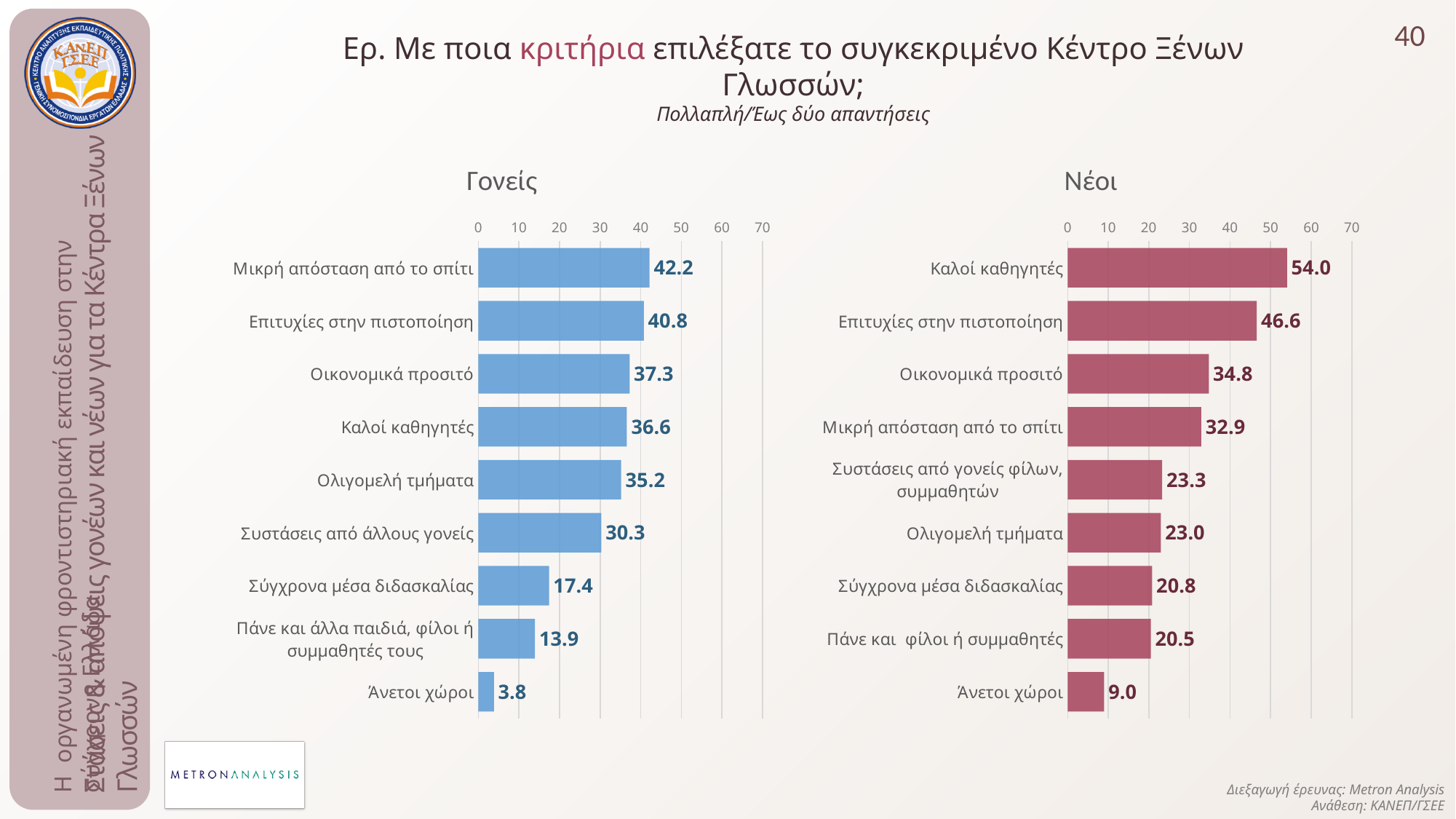
What is the title of the chart on the left side of the slide? Γονείς How many categories are shown in the "Γονείς" chart? 9 Which is larger: "Καλοί καθηγητές" in the "Γονείς" chart or "Καλοί καθηγητές" in the "Νέοι" chart? Νέοι In the "Νέοι" chart, which category has the highest value? Καλοί καθηγητές In the "Γονείς" chart, what is the difference between "Μικρή απόσταση από το σπίτι" and "Άνετοι χώροι"? 38.4 In the "Νέοι" chart, which category has the lowest value? Άνετοι χώροι In the "Γονείς" chart, which category has the highest value? Μικρή απόσταση από το σπίτι What kind of chart is the "Νέοι" chart? bar chart In the "Γονείς" chart, what is the value for "Οικονομικά προσιτό"? 37.3 In the "Νέοι" chart, what is the difference between "Καλοί καθηγητές" and "Επιτυχίες στην πιστοποίηση"? 7.4 In the "Νέοι" chart, is the value for "Οικονομικά προσιτό" greater or less than 30? greater In the "Νέοι" chart, what is the value for "Σύγχρονα μέσα διδασκαλίας"? 20.8